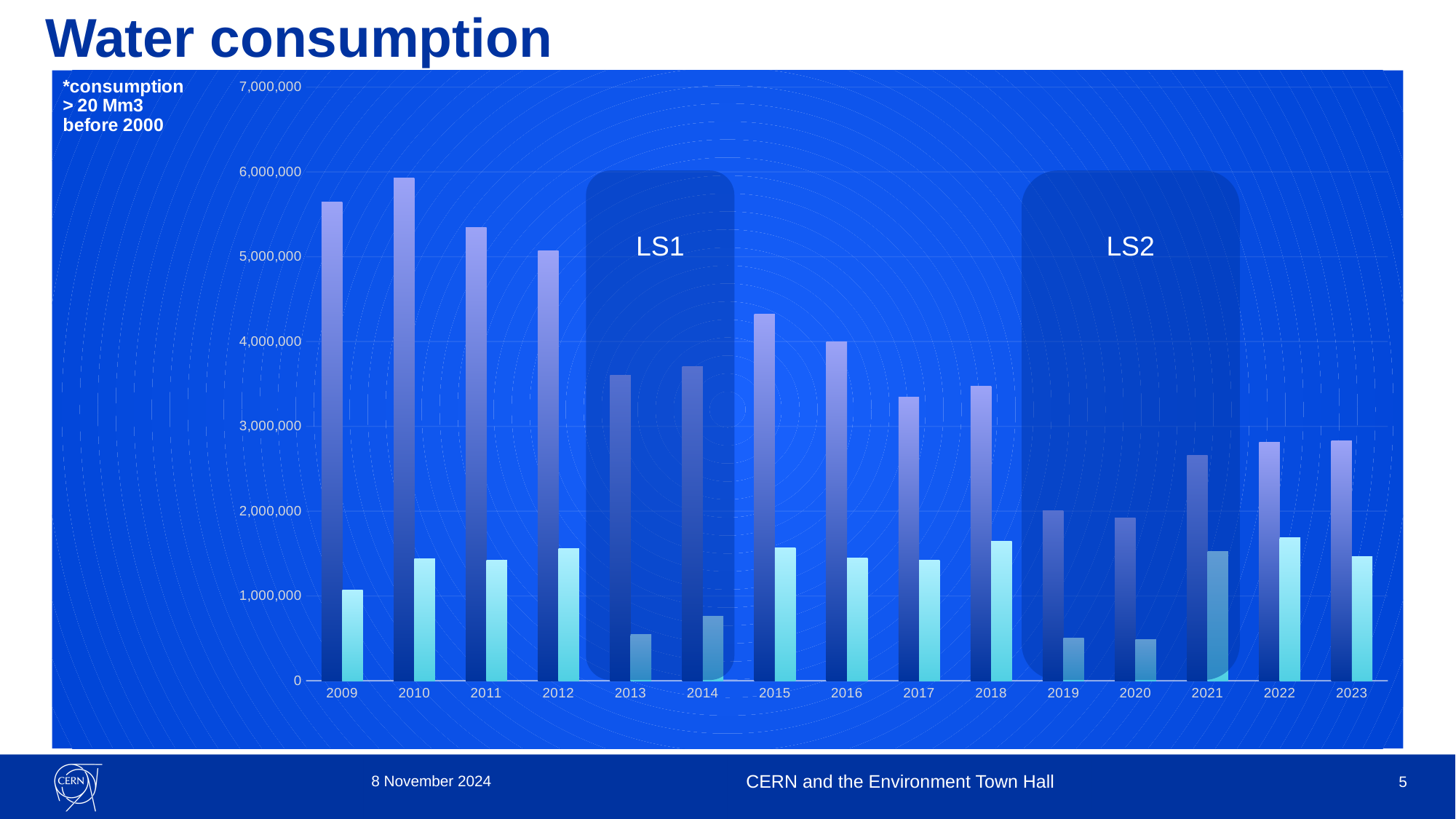
Is the tall bar for 2021 greater or less than 2,000,000? greater Is the tall bar for 2013 greater or less than 3,000,000? greater Which tall bar is larger, 2009 or 2012? 2009 Is the tall bar for 2022 greater or less than 3,000,000? less How many years are shown on the x axis of the chart? 15 What are the two shaded periods on the chart labelled? LS1 and LS2 Which year has the highest tall (blue-purple) bar? 2010 Do the tall bars rise or fall from 2009 to 2012? fall What kind of chart is shown on the slide? bar chart